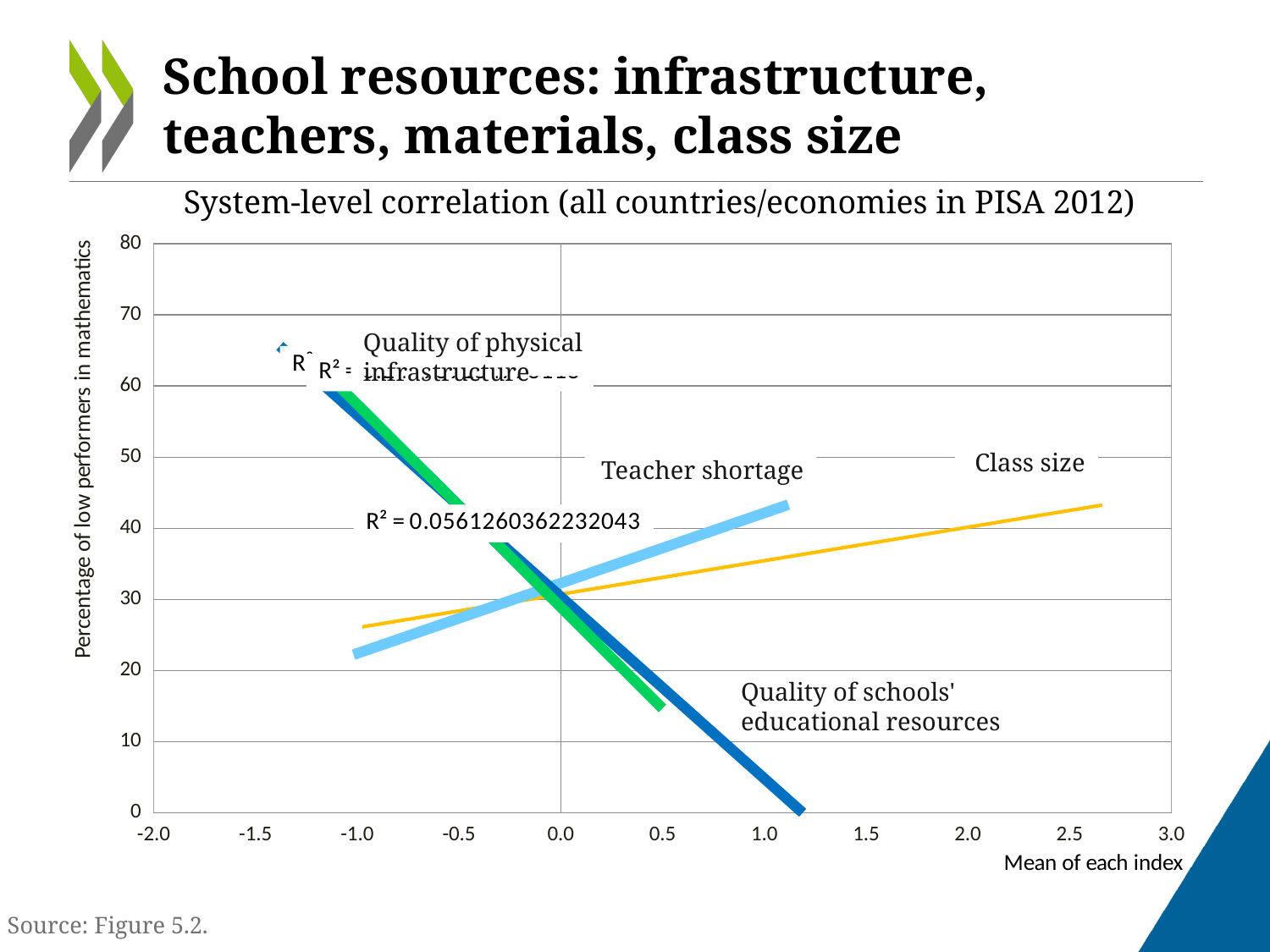
Does the Quality of schools' educational resources line rise or fall along the x axis? fall Does the Teacher shortage line rise or fall along the x axis? rise How many labelled lines are plotted on the chart? 4 Does the Quality of physical infrastructure line rise or fall as the mean of the index increases? fall What kind of chart is shown on the slide? line chart Is the value of the Teacher shortage line at a mean index of -1.0 greater or less than 30? less What is the title of the chart? System-level correlation (all countries/economies in PISA 2012) What R² value is printed on the chart? R² = 0.0561260362232043 At a mean index of 0.5, which line has the higher value: Class size or Quality of schools' educational resources? Class size What is the label of the vertical axis? Percentage of low performers in mathematics Is the value of the Quality of physical infrastructure line at a mean index of -1.0 greater or less than 50? greater